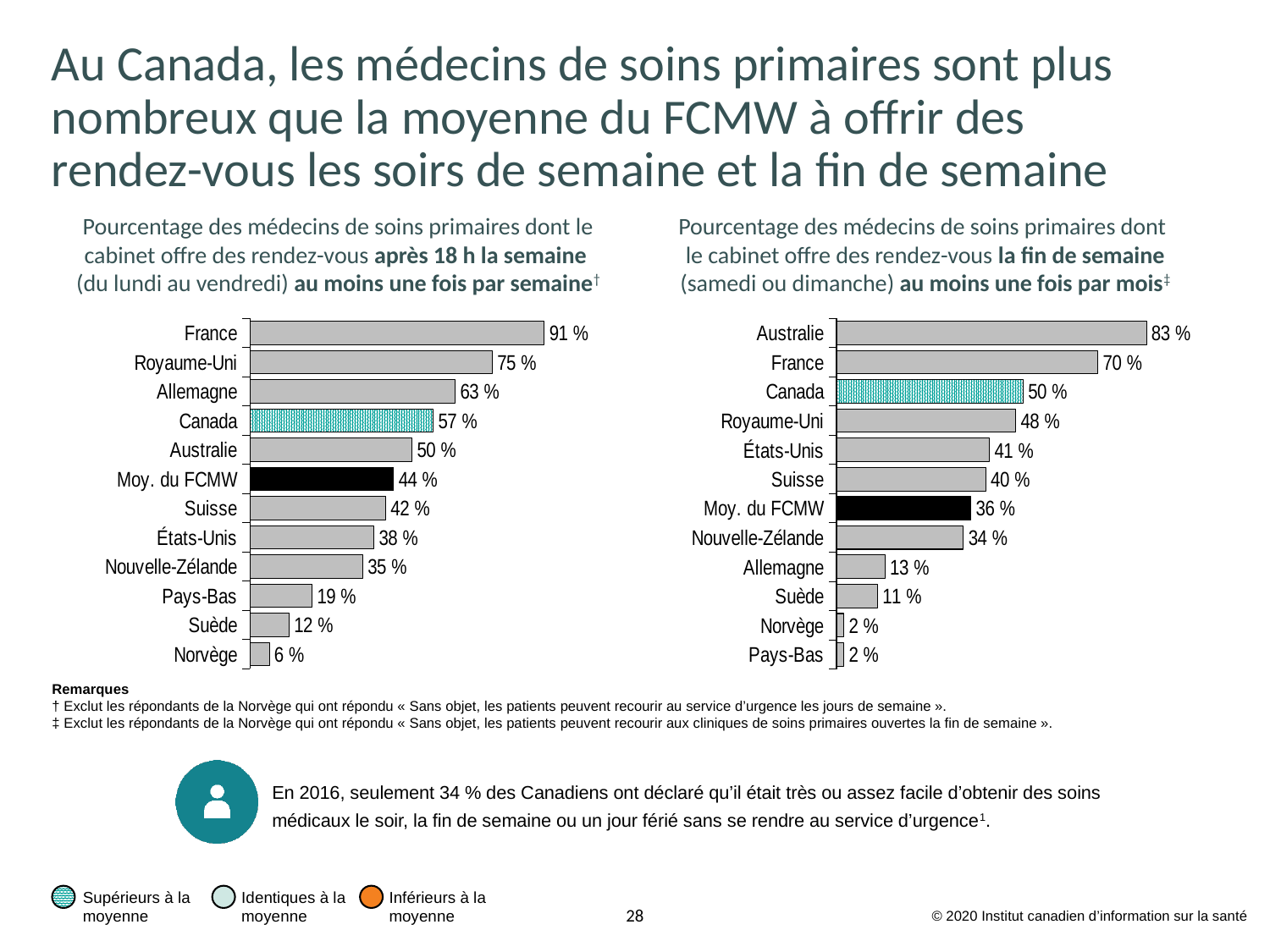
In the left chart (rendez-vous après 18 h la semaine), what is the difference between France and Royaume-Uni? 16 % In the right chart (rendez-vous la fin de semaine), what is the value for Australie? 83 % What type of chart is the left chart (rendez-vous après 18 h la semaine)? Bar chart In the left chart (rendez-vous après 18 h la semaine), which country has the highest value? France How many countries or categories are shown in the right chart (rendez-vous la fin de semaine)? 12 In the right chart (rendez-vous la fin de semaine), what is the difference between Canada and Moy. du FCMW? 14 % In the left chart (rendez-vous après 18 h la semaine), which country has the lowest value? Norvège In the right chart (rendez-vous la fin de semaine), which country has the highest value? Australie In the right chart (rendez-vous la fin de semaine), which is larger, Allemagne or Nouvelle-Zélande? Nouvelle-Zélande In the left chart (rendez-vous après 18 h la semaine), which is larger, Suisse or États-Unis? Suisse In the left chart (rendez-vous après 18 h la semaine), what is the value for Canada? 57 % In the right chart (rendez-vous la fin de semaine), what is the value for Moy. du FCMW? 36 %